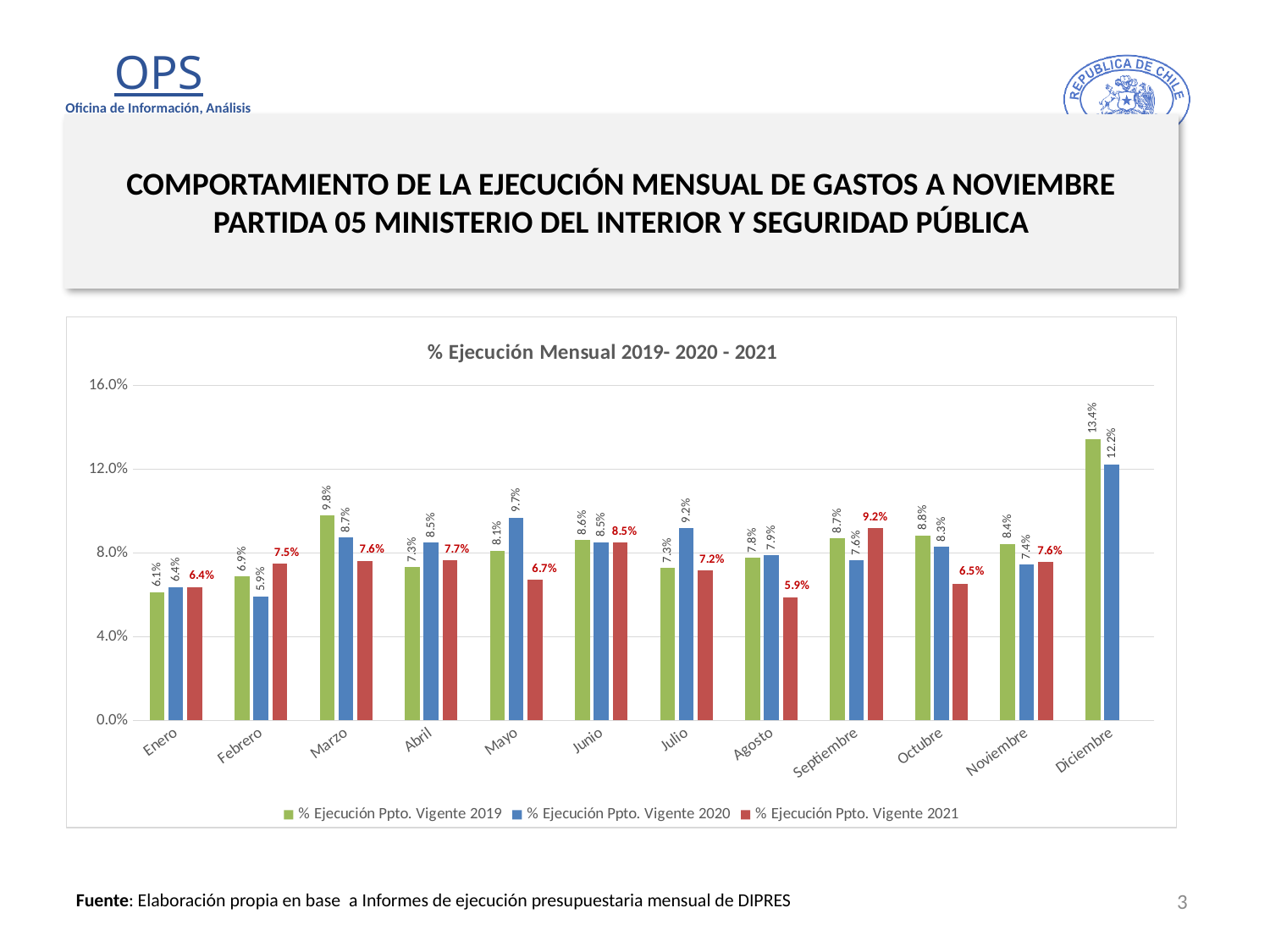
Which is larger in Julio: the 2020 value or the 2021 value? 2020 value What is the title of the chart? % Ejecución Mensual 2019- 2020 - 2021 Which month has the highest value for % Ejecución Ppto. Vigente 2020? Diciembre What is the value for % Ejecución Ppto. Vigente 2020 in Mayo? 9.7% Which month has the lowest value for % Ejecución Ppto. Vigente 2021? Agosto What is the value for % Ejecución Ppto. Vigente 2019 in Diciembre? 13.4% What kind of chart is shown? Bar chart What is the value for % Ejecución Ppto. Vigente 2021 in Septiembre? 9.2% What is the difference between the 2019 and 2020 values in Marzo? 1.1% How many series does the legend list? 3 How many months are shown on the x axis? 12 Is the value for % Ejecución Ppto. Vigente 2019 in Diciembre greater or less than 12.0%? greater